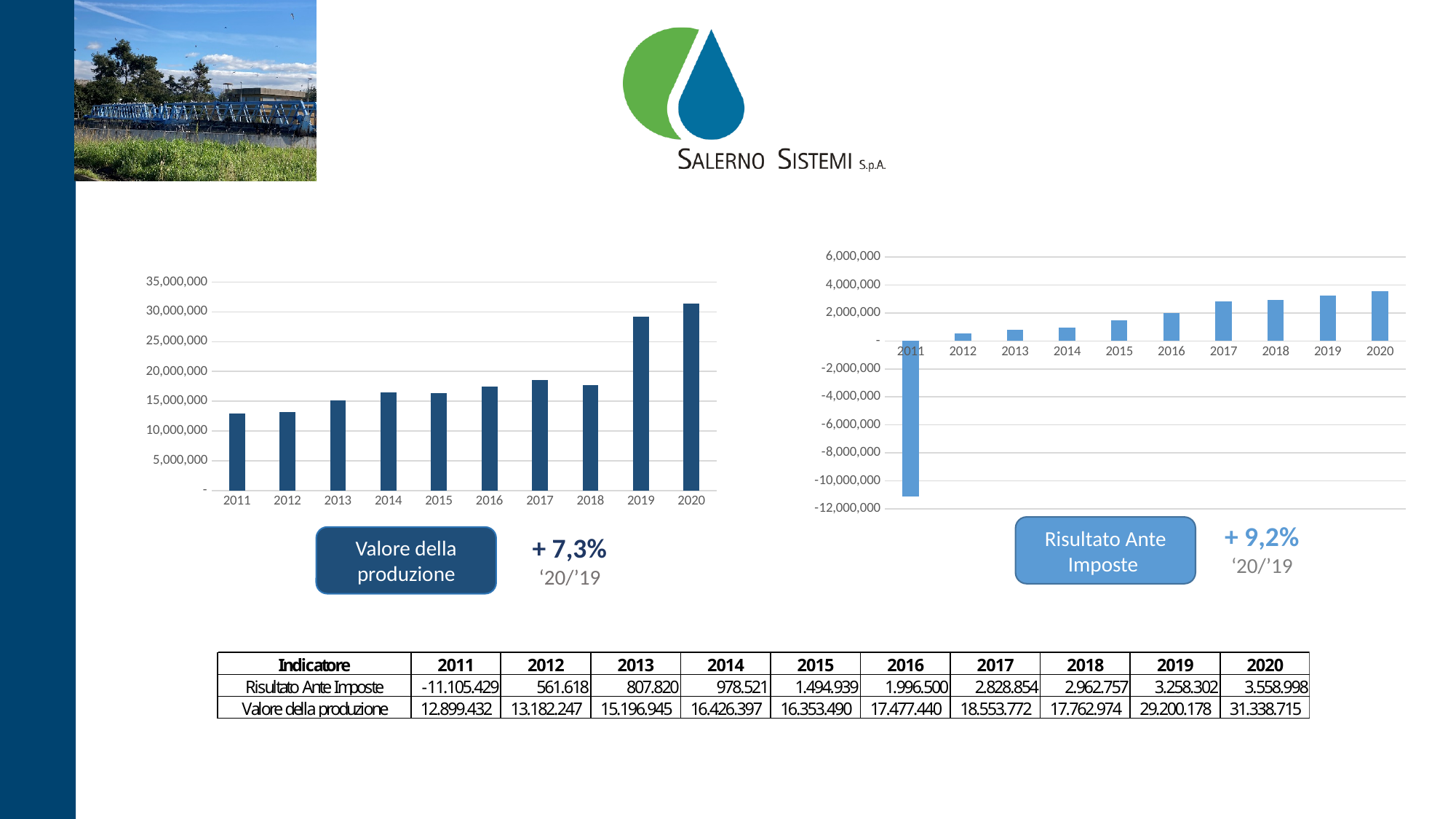
In the Valore della produzione chart, which is larger, the value for 2017 or the value for 2018? 2017 In the Risultato Ante Imposte chart, do the values generally rise or fall from 2012 to 2020? rise How many years are shown on the x axis of the Risultato Ante Imposte chart? 10 In the Risultato Ante Imposte chart, which year has the lowest value? 2011 In the Valore della produzione chart, is the value for 2019 greater or less than 25,000,000? greater In the Risultato Ante Imposte chart, what is the value for 2011? -11.105.429 In the Valore della produzione chart, which year has the lowest value? 2011 What percentage change '20/'19 is shown next to the Risultato Ante Imposte chart? + 9,2% What kind of chart is the Valore della produzione chart? bar chart In the Risultato Ante Imposte chart, is the value for 2016 greater or less than 4,000,000? less In the Valore della produzione chart, which year has the highest value? 2020 In the Valore della produzione chart, what is the value for 2020? 31.338.715